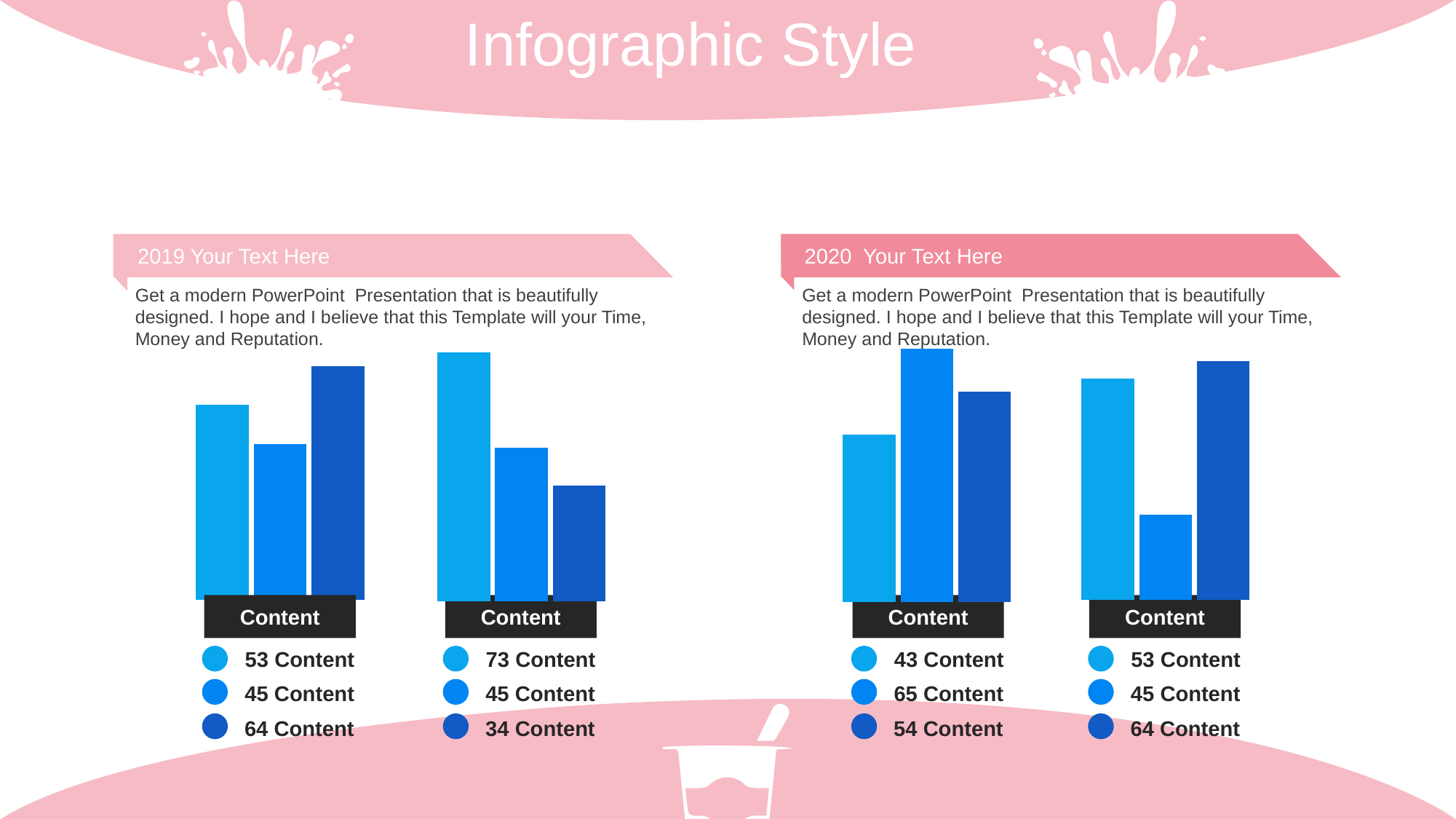
In the second chart from the left (under 2019), what is the highest value? 73 How many bars does the leftmost chart (under 2019) contain? 3 In the leftmost chart (under 2019), what is the lowest value listed in its legend? 45 In the third chart from the left (first chart under 2020), what is the highest value? 65 In the second chart from the left (under 2019), do the bar values rise or fall from left to right? fall In the second chart from the left (under 2019), what is the difference between the highest and lowest values? 39 What type of chart is used in each of the four charts on the slide? bar chart How many charts are shown on the slide? 4 In the leftmost chart (under 2019), what is the highest value listed in its legend? 64 In the third chart from the left (first chart under 2020), what is the difference between the highest value and the lowest value? 22 In the second chart from the left (under 2019), what is the lowest value? 34 What label appears in the dark box beneath each chart? Content